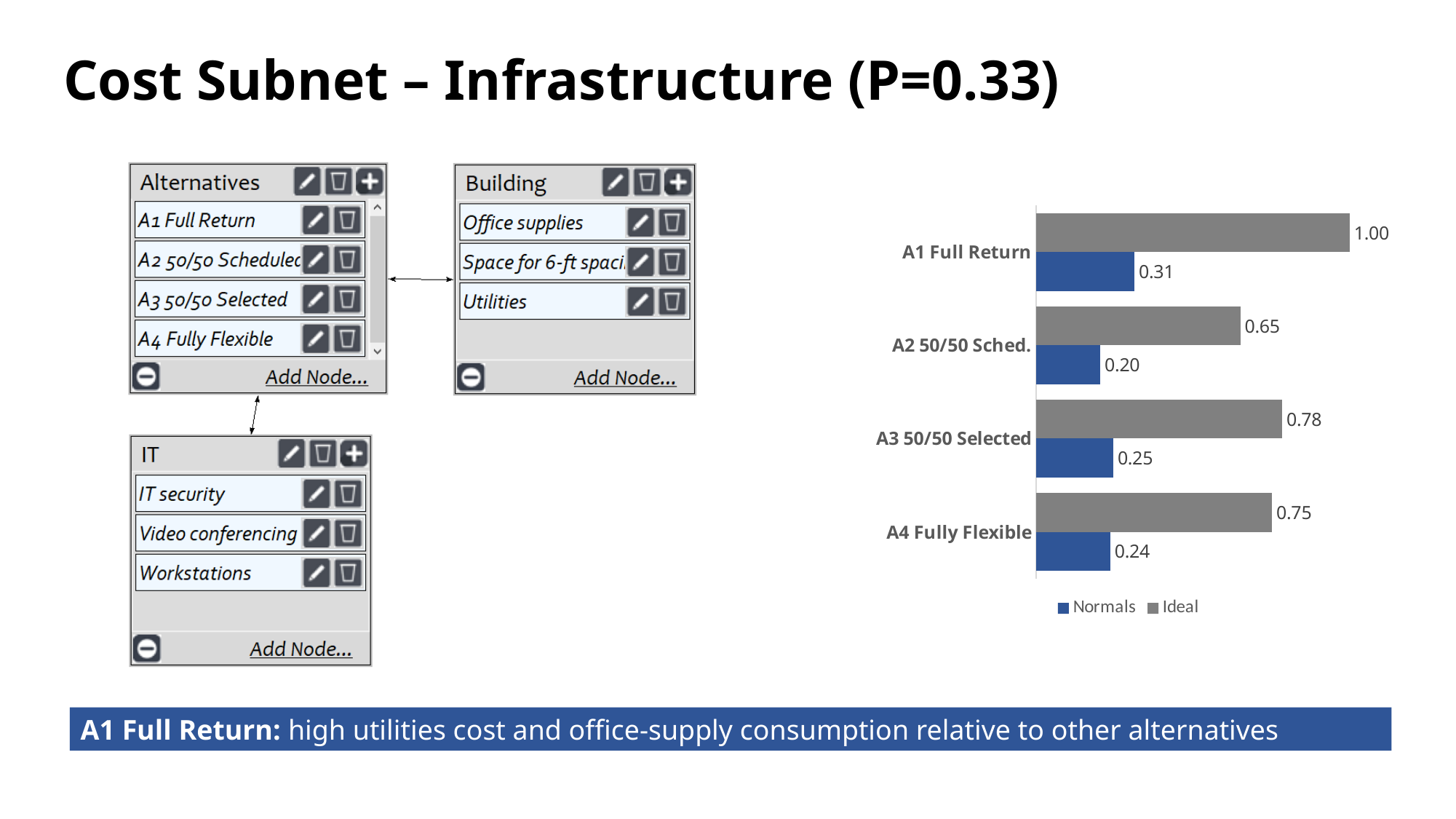
How many alternatives are shown on the chart? 4 Which colour represents the Ideal series in the chart? Grey What is the Normals value for A4 Fully Flexible? 0.24 What is the Ideal value for A1 Full Return? 1.00 What is the difference between the Ideal values for A3 50/50 Selected and A4 Fully Flexible? 0.03 Which alternative has the lowest Normals value? A2 50/50 Sched. What is the Ideal value for A3 50/50 Selected? 0.78 What is the Normals value for A2 50/50 Sched.? 0.20 Which alternative has the highest Ideal value? A1 Full Return What type of chart is shown on the slide? Bar chart How many series does the chart legend list? 2 Which is larger, the Normals value for A1 Full Return or the Normals value for A3 50/50 Selected? A1 Full Return